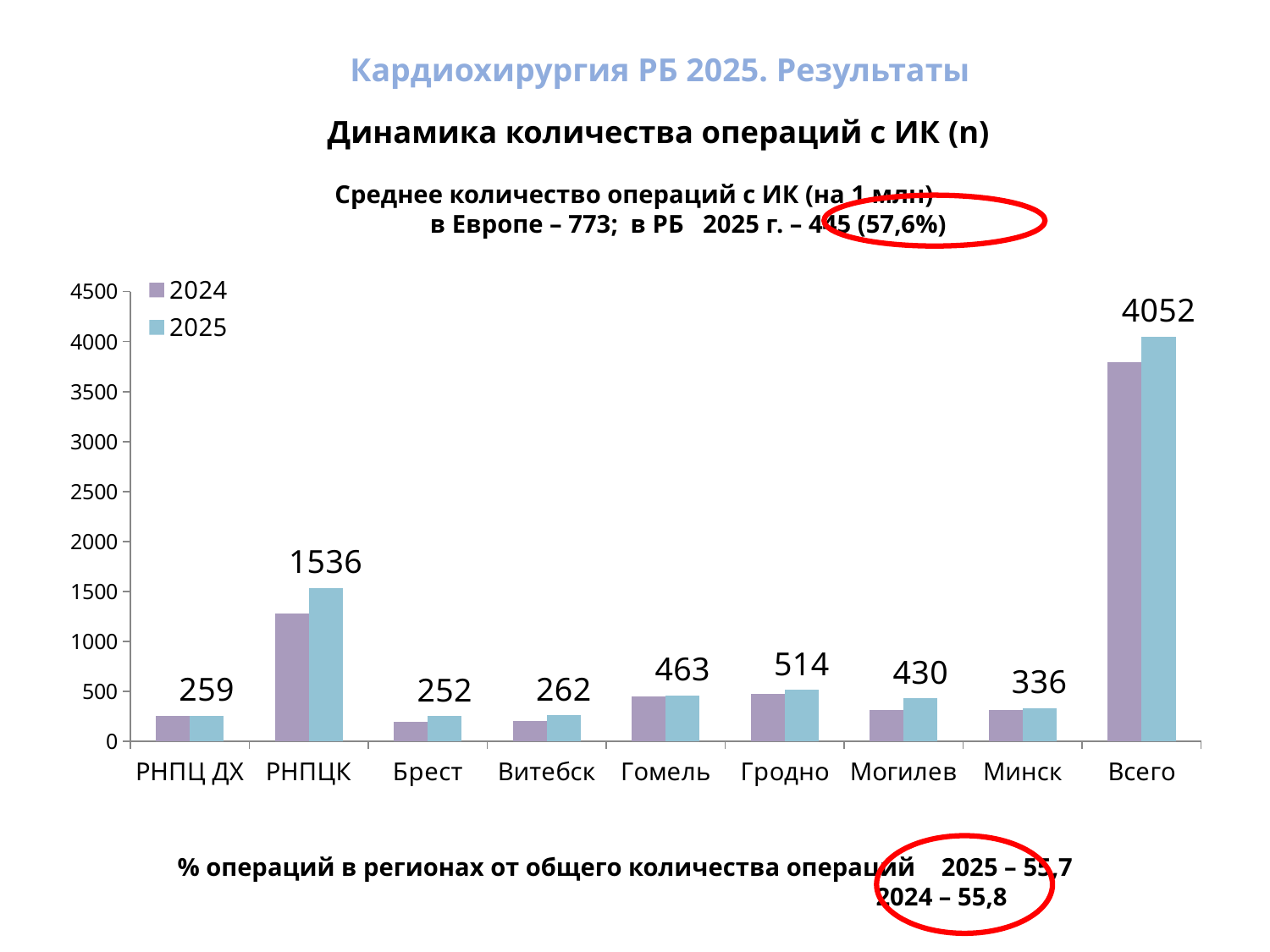
What is the 2025 value for РНПЦК? 1536 Which category has the lowest 2025 value? Брест Is the 2024 value for РНПЦК greater or less than 1500? less What is the 2025 value for Минск? 336 How many series does the legend list? 2 Which category has the highest 2025 value? Всего Which has the larger 2025 value, Могилев or Минск? Могилев What kind of chart is shown on the slide? bar chart What is the difference between the 2025 values for Гродно and Гомель? 51 What is the 2025 value for Всего? 4052 How many categories are shown on the x axis? 9 What is the 2025 value for Гродно? 514